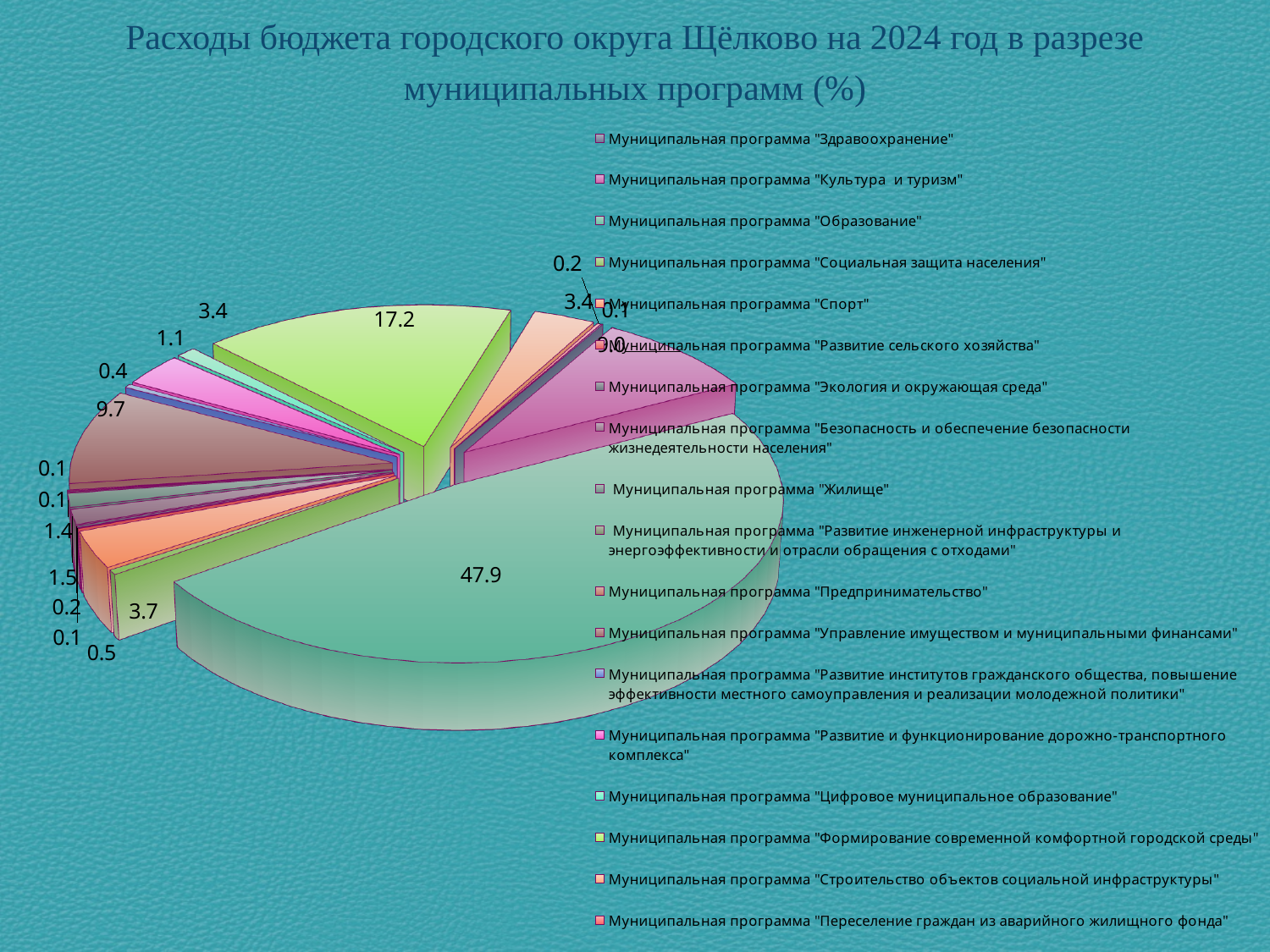
Does the largest slice account for more or less than half of the pie? less What is the value of the second-largest slice of the pie? 17.2 What is the third-largest value labelled on the pie? 9.7 What is the combined value of the two largest slices (47.9 and 17.2)? 65.1 How many municipal programmes are listed in the chart legend? 18 Which is larger, the slice labelled 9.7 or the slice labelled 3.7? 9.7 What kind of chart is shown on the slide? pie chart What is the title of the chart? Расходы бюджета городского округа Щёлково на 2024 год в разрезе муниципальных программ (%) What is the value of the largest slice of the pie? 47.9 Which legend entry is listed first in the chart legend? Муниципальная программа "Здравоохранение" What is the difference between the two largest slices, 47.9 and 17.2? 30.7